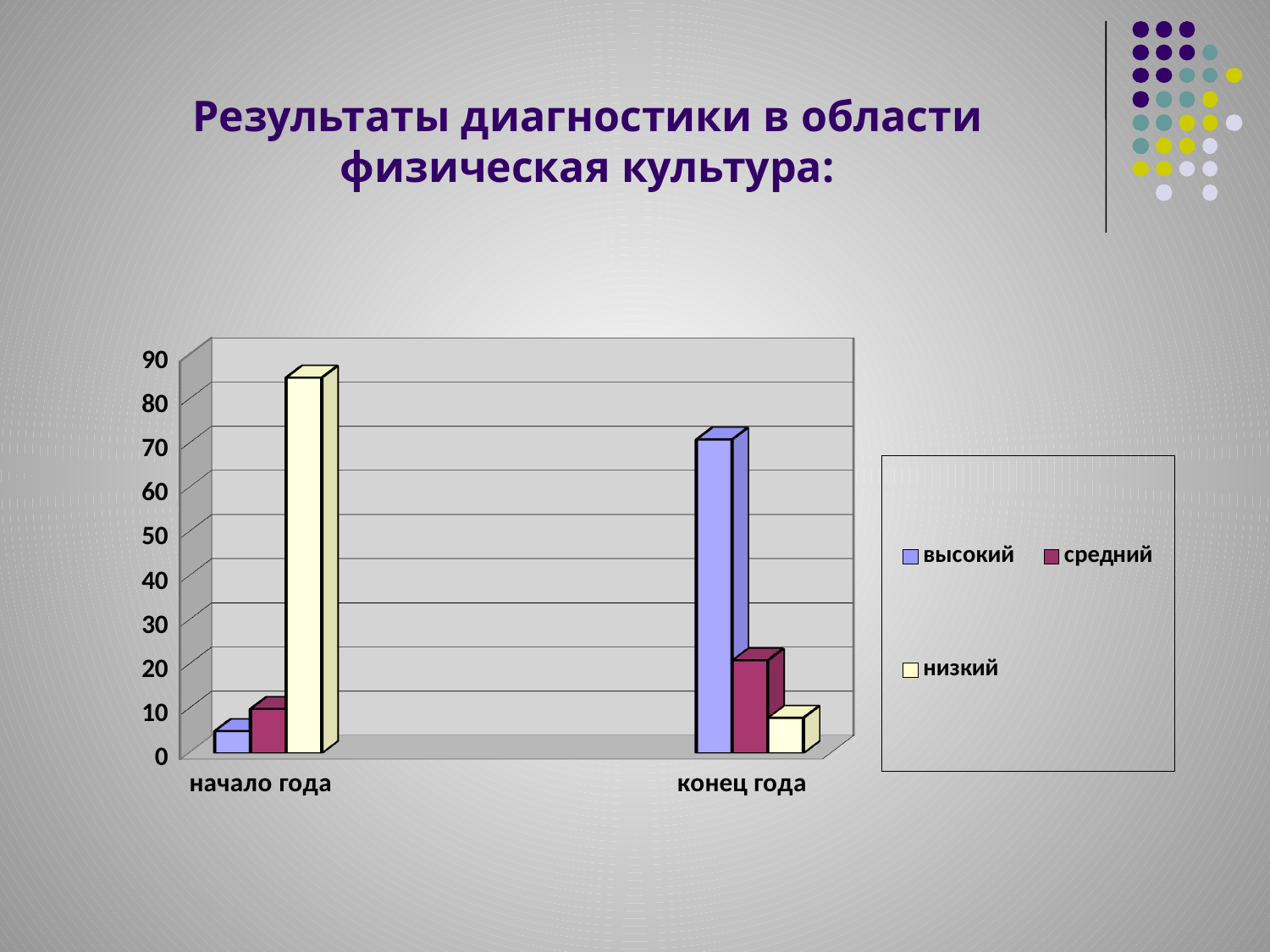
Which series has the highest value for начало года? низкий What kind of chart is shown on the slide? bar chart Which series has the lowest value for конец года? низкий Is the value for высокий larger at начало года or at конец года? конец года Which series has the highest value for конец года? высокий Does the value for низкий rise or fall from начало года to конец года? fall Is the value for средний at конец года greater or less than 30? less How many categories are shown on the x axis? 2 Which series has the lowest value for начало года? высокий How many series does the legend list? 3 Is the value for высокий at конец года greater or less than 60? greater Is the value for низкий at начало года greater or less than 80? greater